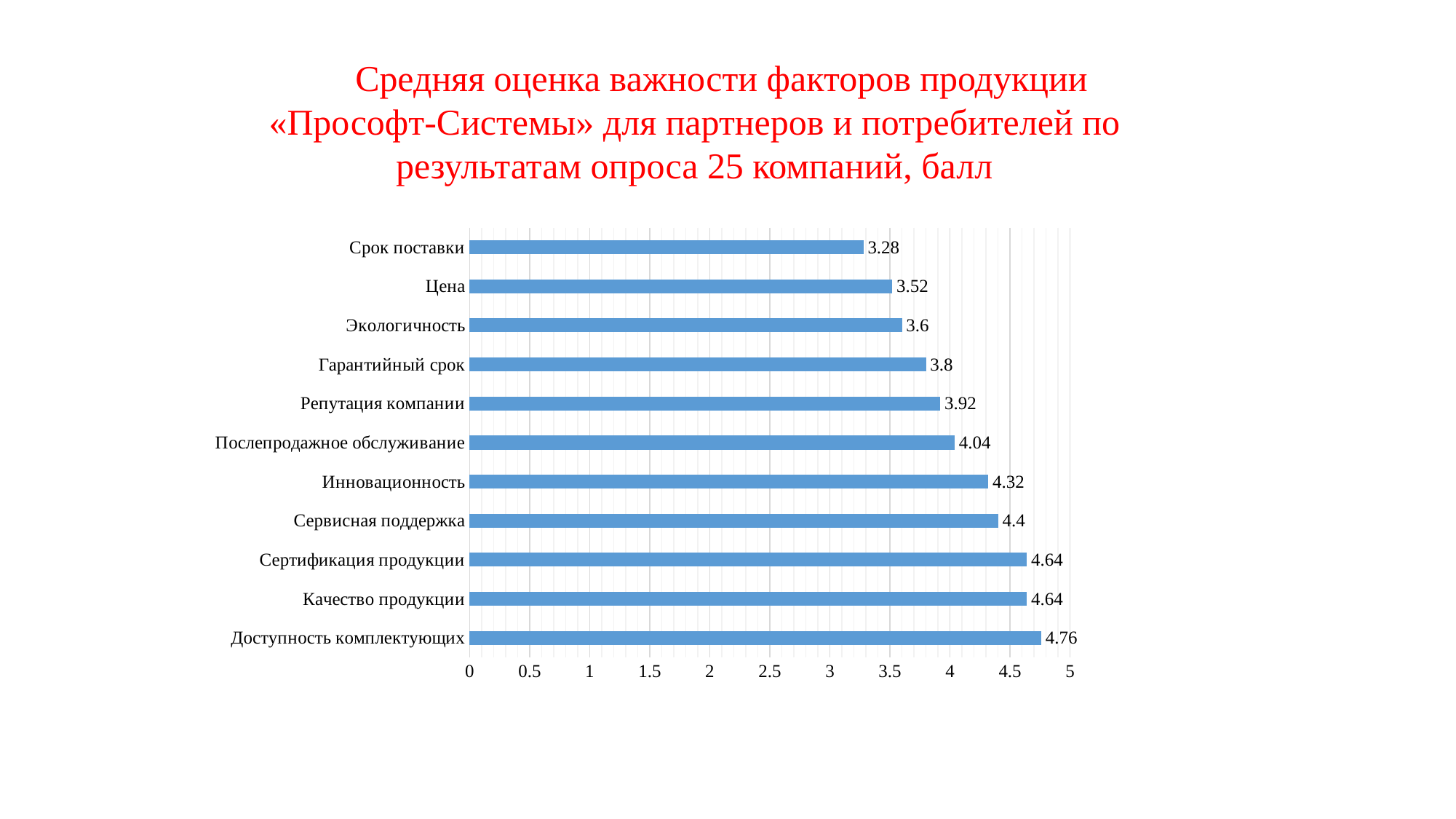
What is the value for Доступность комплектующих? 4.76 What kind of chart is shown on the slide? bar chart Which category has the lowest value? Срок поставки What is the difference between the values for Доступность комплектующих and Срок поставки? 1.48 What is the value for Репутация компании? 3.92 What colour are the bars in the chart? blue What is the difference between the values for Сервисная поддержка and Цена? 0.88 Which is larger, the value for Инновационность or the value for Гарантийный срок? Инновационность What is the value for Срок поставки? 3.28 How many categories are shown in the chart? 11 Is the value for Экологичность greater or less than 4? less Which category has the highest value? Доступность комплектующих